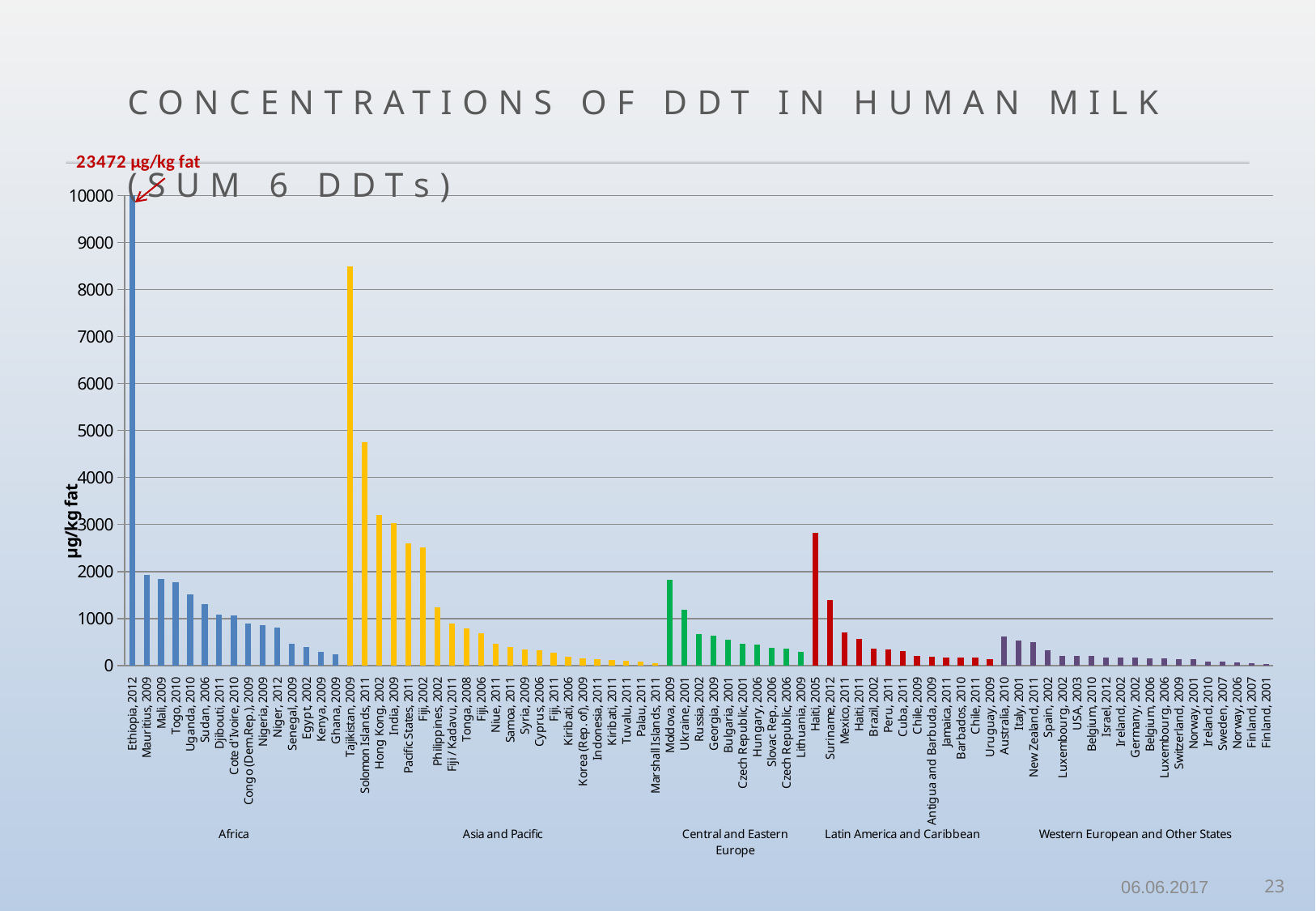
Which is larger, the value for Togo, 2010 or the value for Ghana, 2009? Togo, 2010 How many regional groups are labelled along the x axis? 5 Within the Africa group, do the values rise or fall from left to right? fall Is the value for Haiti, 2005 greater or less than 2000? greater Which is larger, the value for Solomon Islands, 2011 or the value for Hong Kong, 2002? Solomon Islands, 2011 Is the value for Mauritius, 2009 greater or less than 1000? greater Which is larger, the value for Tajikistan, 2009 or the value for Haiti, 2005? Tajikistan, 2009 Which country and year has the highest DDT concentration in the chart? Ethiopia, 2012 What kind of chart is shown on the slide? bar chart What value is annotated for Ethiopia, 2012? 23472 µg/kg fat Is the value for Moldova, 2009 greater or less than 1000? greater